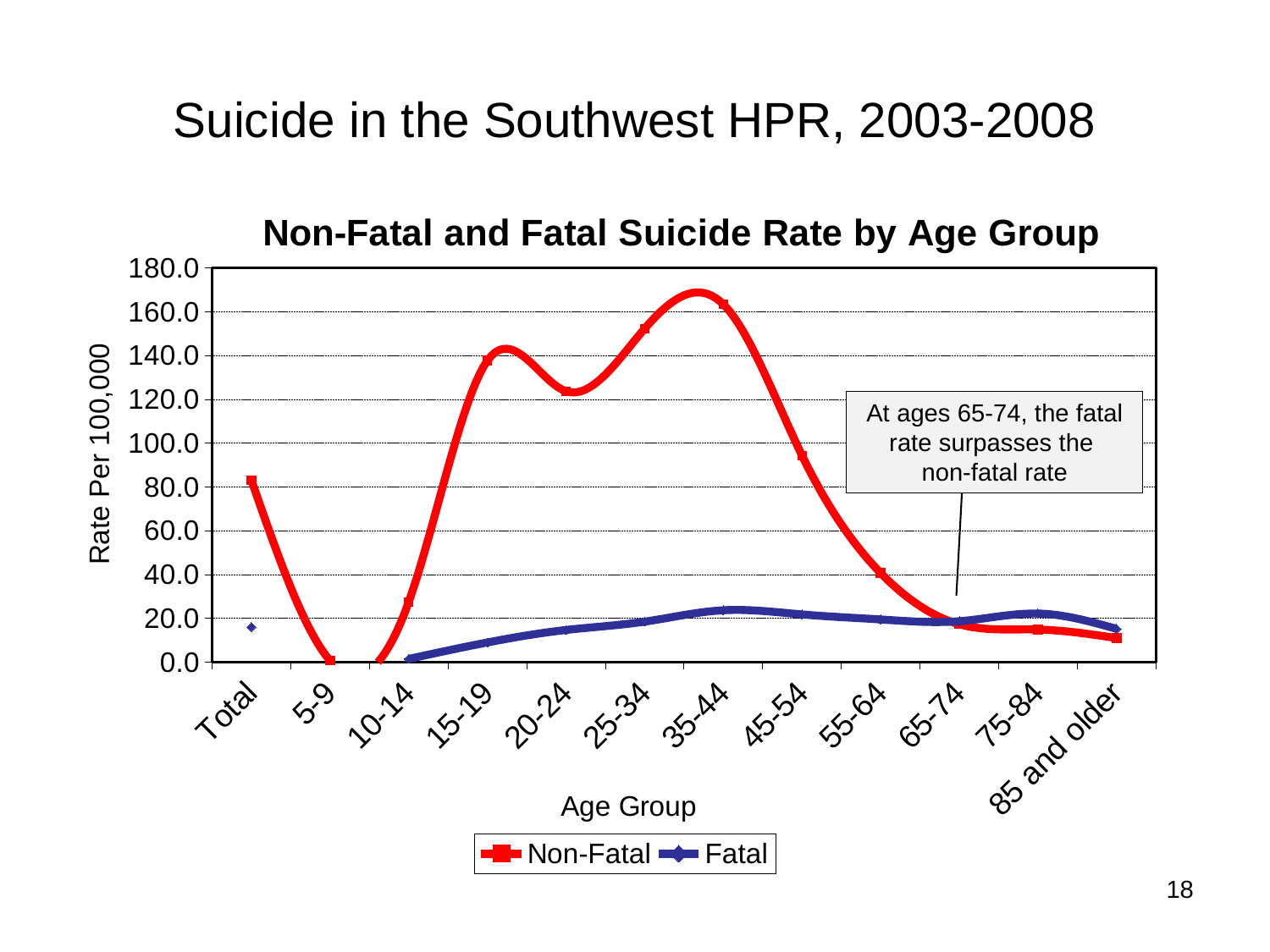
How many series does the legend list? 2 How many age group categories are shown on the x axis? 12 According to the annotation on the chart, at which age group does the fatal rate surpass the non-fatal rate? 65-74 Does the Non-Fatal rate rise or fall from the 35-44 age group to the 85 and older age group? Fall Is the Non-Fatal rate for the 35-44 age group greater or less than 140? greater Which is larger for the 15-19 age group, the Non-Fatal rate or the Fatal rate? Non-Fatal Is the Non-Fatal rate for the Total category greater or less than 100? less Is the Fatal rate for the 35-44 age group greater or less than 40? less What kind of chart is shown on the slide? Line chart Which age group has the highest Non-Fatal suicide rate? 35-44 What is the title of the chart? Non-Fatal and Fatal Suicide Rate by Age Group